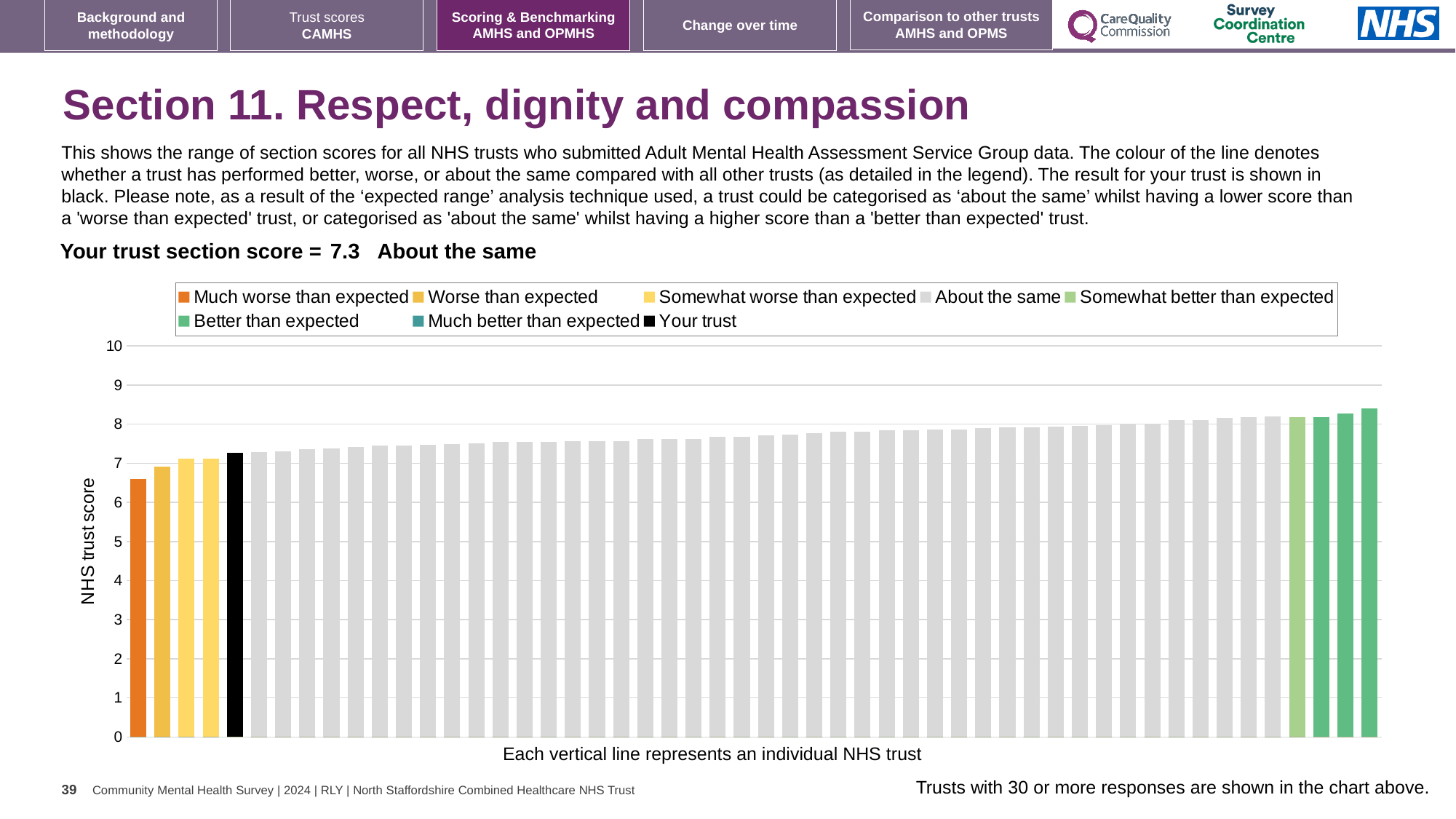
How many series does the legend list? 8 What is the section score for your trust? 7.3 Is the value for your trust greater or less than 7? greater Do the bar values rise or fall from left to right along the x axis? rise Which legend category does the shortest bar belong to? Much worse than expected Is the value of the tallest bar greater or less than 8? greater What is the label on the y axis? NHS trust score How many bars are coloured as 'Much worse than expected'? 1 Which legend category does the tallest bar belong to? Better than expected Is the value of the 'Much worse than expected' bar greater or less than 7? less What kind of chart is shown on the slide? bar chart How many bars are coloured as 'Better than expected'? 3